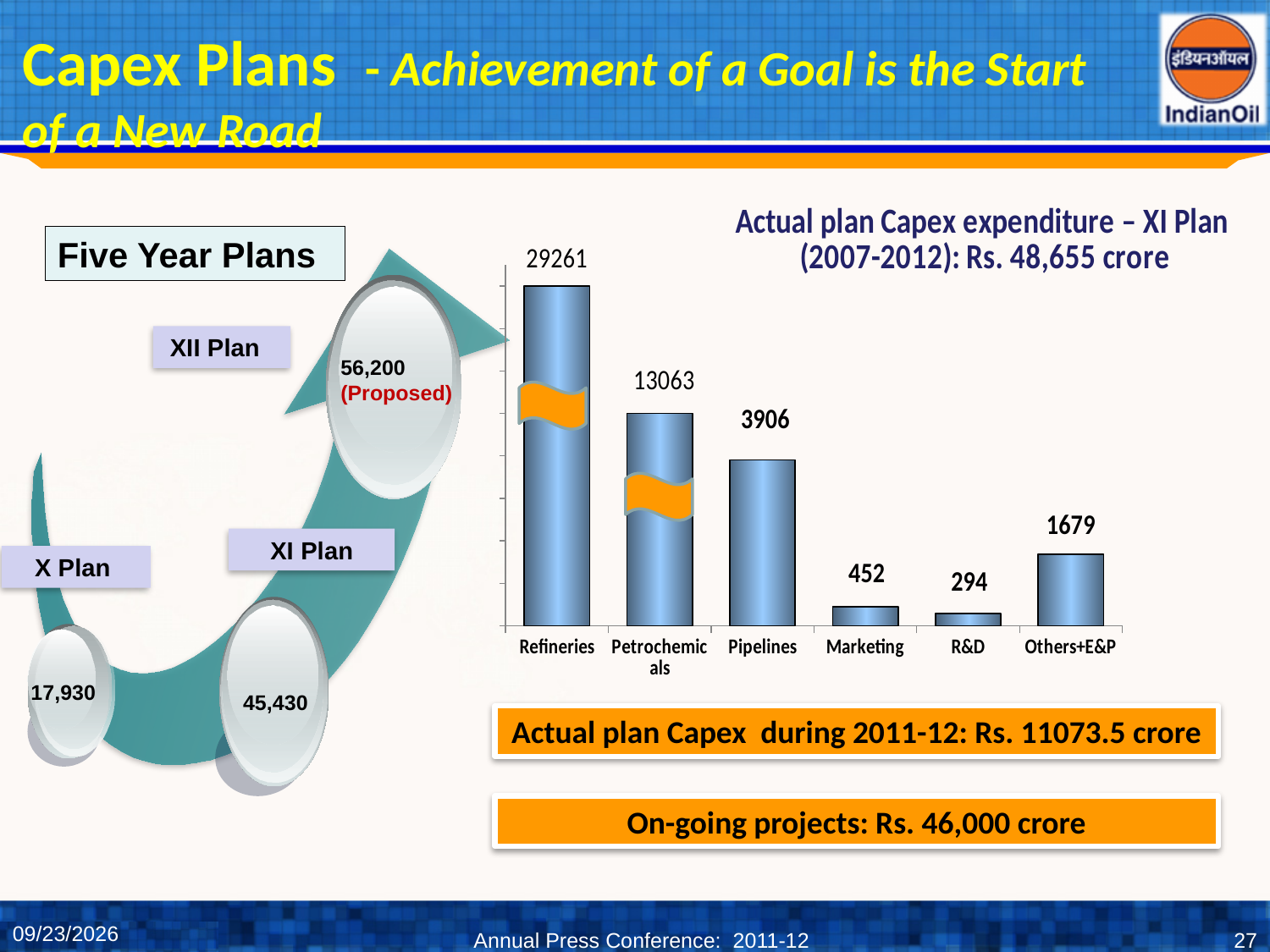
In the Actual plan Capex expenditure – XI Plan chart, which is larger: Marketing or Others+E&P? Others+E&P What is the value for Petrochemicals in the Actual plan Capex expenditure – XI Plan chart? 13063 Which category has the lowest value in the Actual plan Capex expenditure – XI Plan chart? R&D Which category has the highest value in the Actual plan Capex expenditure – XI Plan chart? Refineries What is the value for Refineries in the Actual plan Capex expenditure – XI Plan chart? 29261 What is the value for R&D in the Actual plan Capex expenditure – XI Plan chart? 294 What kind of chart is the Actual plan Capex expenditure – XI Plan chart? Bar chart What is the value for Pipelines in the Actual plan Capex expenditure – XI Plan chart? 3906 How many categories are shown in the Actual plan Capex expenditure – XI Plan chart? 6 What is the difference between the Refineries and Petrochemicals values in the Actual plan Capex expenditure – XI Plan chart? 16198 What total amount is stated in the title of the Actual plan Capex expenditure – XI Plan chart? Rs. 48,655 crore What is the value for Others+E&P in the Actual plan Capex expenditure – XI Plan chart? 1679